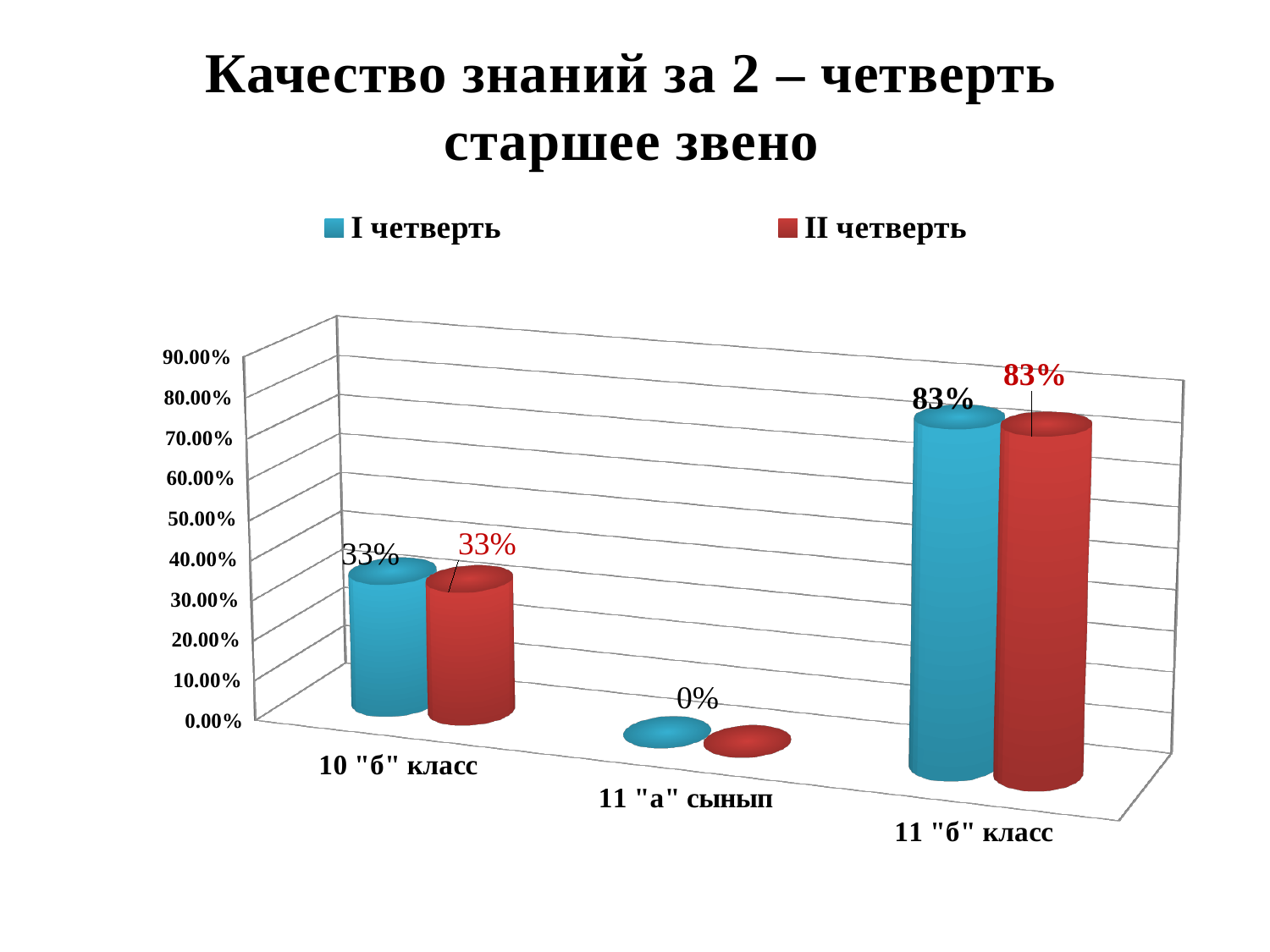
What is the value for 11 "б" класс in II четверть? 83% How many classes are shown on the x axis? 3 Which class has the highest value in I четверть? 11 "б" класс What is the value for 10 "б" класс in I четверть? 33% How many series does the legend list? 2 What kind of chart is shown on the slide? bar chart Which class has the lowest value in II четверть? 11 "а" сынып What is the difference between the I четверть values for 11 "б" класс and 10 "б" класс? 50% Which is larger in II четверть: 10 "б" класс or 11 "б" класс? 11 "б" класс Is the I четверть value for 11 "б" класс greater or less than 50.00%? greater What value is labelled for 11 "а" сынып? 0% Which colour represents II четверть in the legend? red